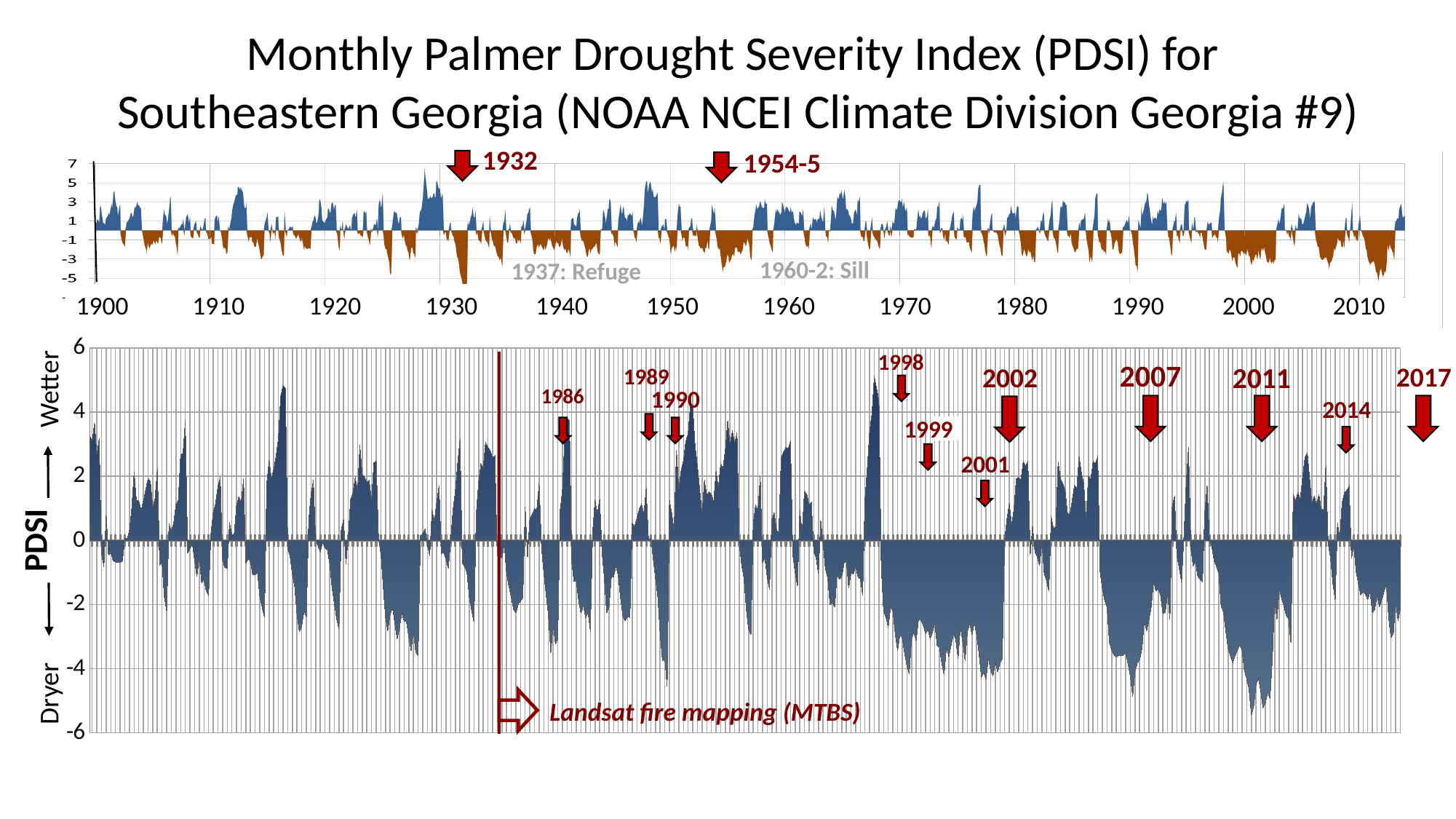
In the bottom chart, what is the highest value shown on the y-axis? 6 In the bottom chart, is the lowest PDSI value near the 2011 arrow greater or less than -4? less What is the title of the slide's charts? Monthly Palmer Drought Severity Index (PDSI) for Southeastern Georgia (NOAA NCEI Climate Division Georgia #9) In the top chart, what event is labelled for 1937? Refuge In the top chart, what is the latest year labelled on the x-axis? 2010 In the top chart, what is the earliest year labelled on the x-axis? 1900 In the top chart, which annotated year marks the lowest PDSI value in the series? 1932 In the top chart, what is the highest value shown on the y-axis? 7 In the top chart, is the PDSI value at the 1932 arrow greater or less than -3? less In the bottom chart, what is the lowest value shown on the y-axis? -6 In the bottom chart, is the PDSI peak near the 1998 arrow greater or less than 4? greater